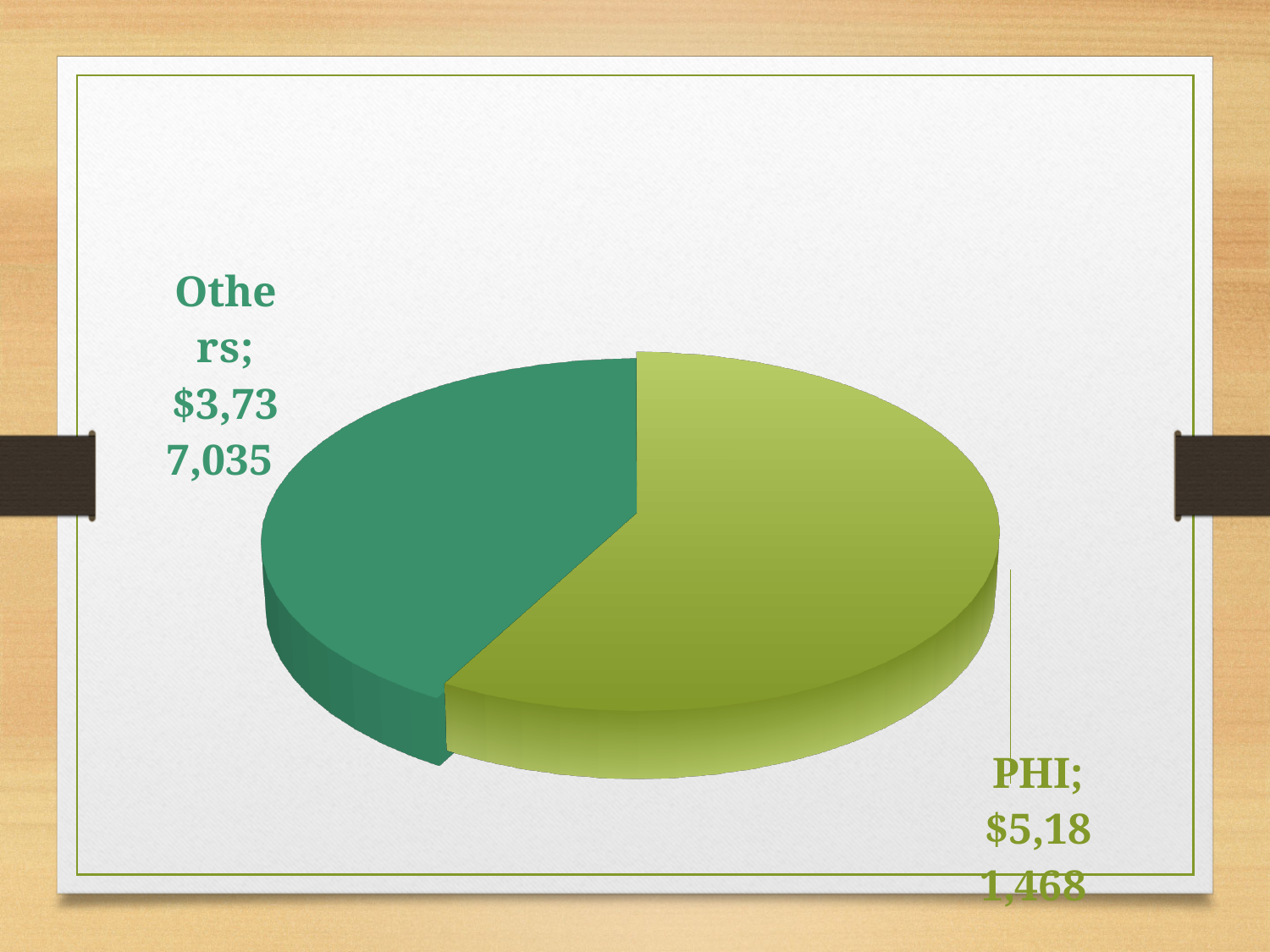
What kind of chart is shown on the slide? pie chart Which slice is the largest? PHI What colour is the Others slice? dark green Which slice is the smallest? Others What is the value of the Others slice? $3,737,035 What is the value of the PHI slice? $5,181,468 What is the total of the two slices in the pie chart? $8,918,503 Which is larger, PHI or Others? PHI How many slices does the pie chart have? 2 What is the difference between the PHI value and the Others value? $1,444,433 What colour is the PHI slice? light green